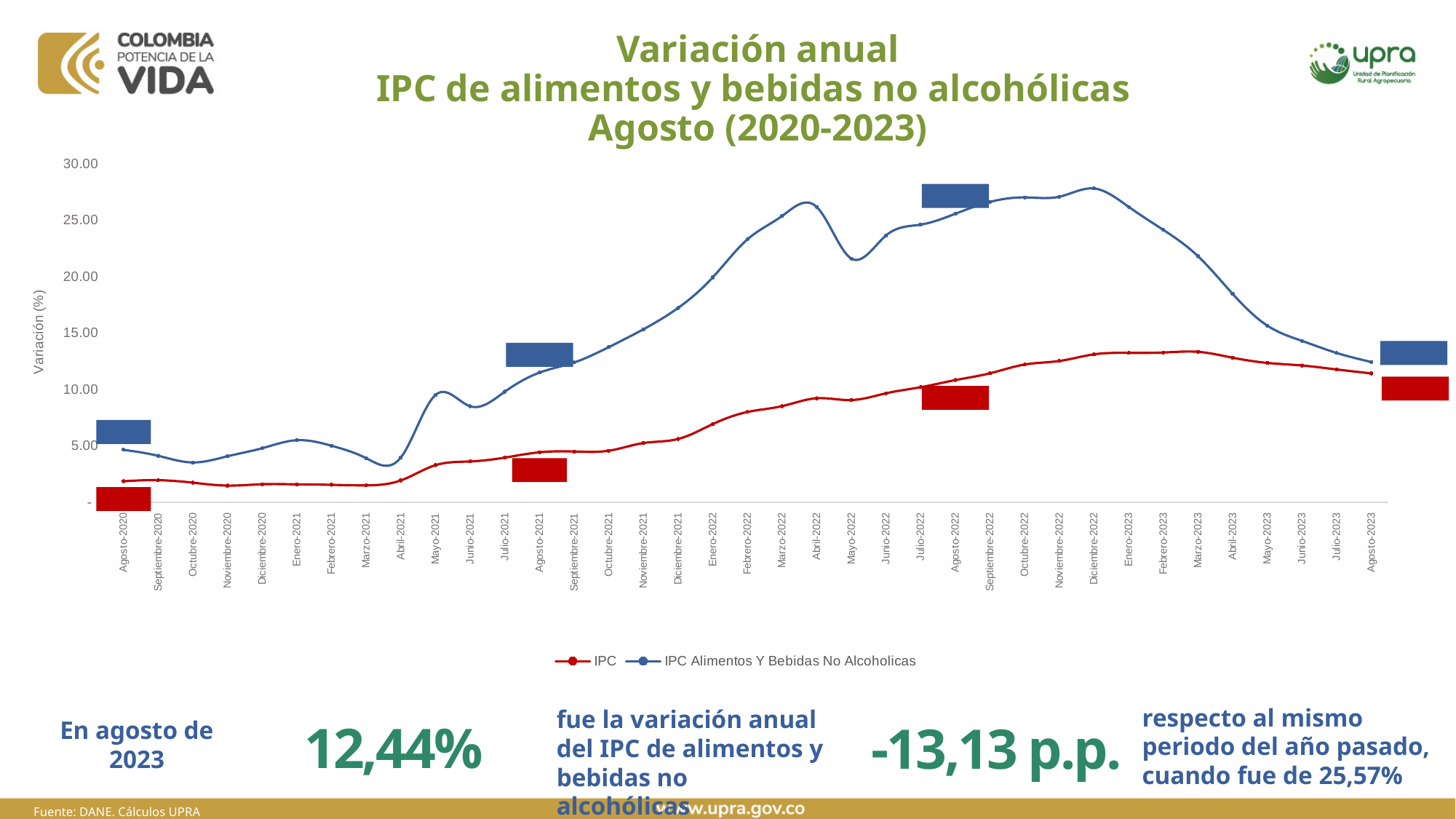
In which month does the IPC Alimentos Y Bebidas No Alcoholicas series reach its highest value? Diciembre-2022 How many monthly points are plotted along the x axis, from Agosto-2020 to Agosto-2023? 37 Is the value of IPC Alimentos Y Bebidas No Alcoholicas in Abril-2022 greater or less than 25.00? greater What was the annual variation of the IPC de alimentos y bebidas no alcohólicas in Agosto-2023? 12,44% Does the IPC Alimentos Y Bebidas No Alcoholicas series rise or fall between Diciembre-2022 and Agosto-2023? fall In Agosto-2022, which series has the larger value, IPC or IPC Alimentos Y Bebidas No Alcoholicas? IPC Alimentos Y Bebidas No Alcoholicas What kind of chart is shown on the slide? line chart What was the annual variation of the IPC de alimentos y bebidas no alcohólicas in Agosto-2022? 25,57% Is the value of the IPC series in Diciembre-2022 greater or less than 10.00? greater How many series does the legend list? 2 By how many percentage points did the IPC de alimentos y bebidas no alcohólicas change from Agosto-2022 to Agosto-2023? -13,13 p.p.